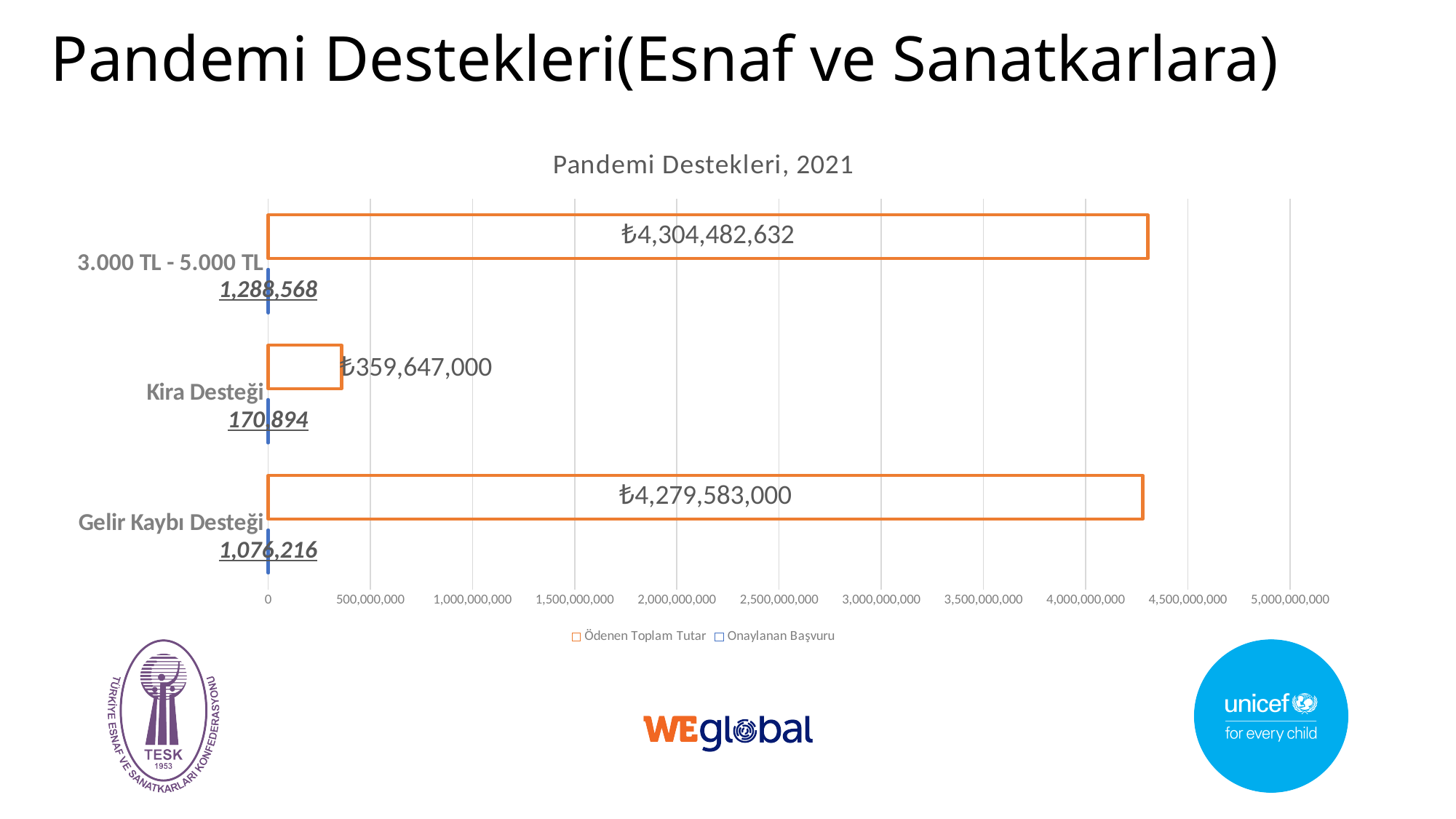
What is the difference in Onaylanan Başvuru between 3.000 TL - 5.000 TL and Gelir Kaybı Desteği? 212,352 What is the Ödenen Toplam Tutar value for Kira Desteği? ₺359,647,000 What is the difference in Ödenen Toplam Tutar between 3.000 TL - 5.000 TL and Gelir Kaybı Desteği? ₺24,899,632 Which category has the highest Onaylanan Başvuru? 3.000 TL - 5.000 TL What is the Onaylanan Başvuru value for 3.000 TL - 5.000 TL? 1,288,568 Which category has the lowest Ödenen Toplam Tutar? Kira Desteği What is the Onaylanan Başvuru value for Kira Desteği? 170,894 How many categories are shown on the chart? 3 How many series does the legend list? 2 What is the Ödenen Toplam Tutar value for Gelir Kaybı Desteği? ₺4,279,583,000 What type of chart is shown on the slide? Bar chart Which has a larger Ödenen Toplam Tutar, Kira Desteği or Gelir Kaybı Desteği? Gelir Kaybı Desteği